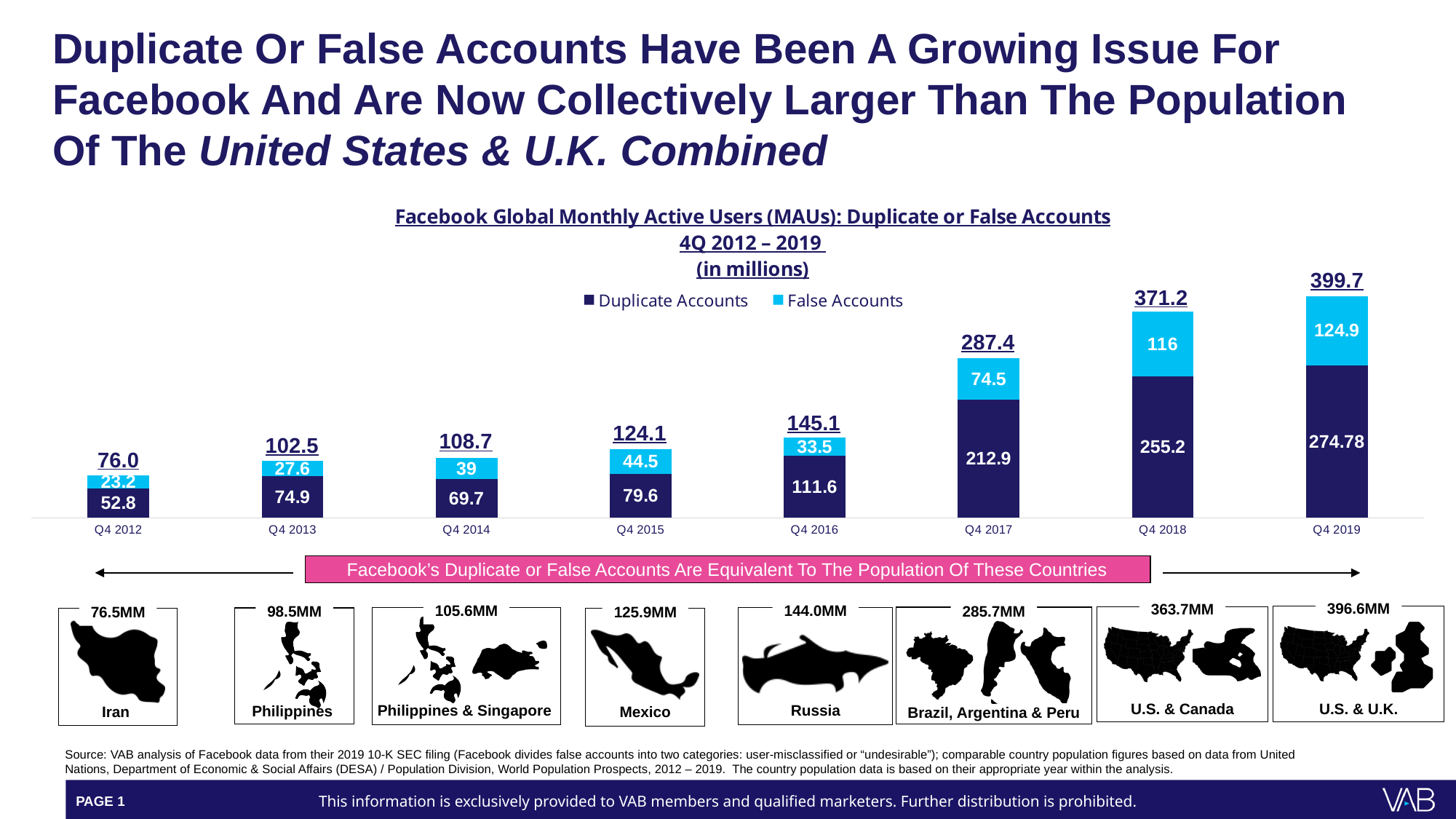
What is the difference between the False Accounts values for Q4 2018 and Q4 2017? 41.5 What is the value of False Accounts for Q4 2015? 44.5 Which quarter has the lowest value for False Accounts? Q4 2012 What is the total of the stacked bar for Q4 2017? 287.4 What is the value of Duplicate Accounts for Q4 2016? 111.6 How many quarters are shown on the x axis of the chart? 8 How many series does the chart legend list? 2 Which is larger, the Duplicate Accounts value for Q4 2013 or for Q4 2014? Q4 2013 What kind of chart is shown on the slide? Stacked bar chart Do the total values generally rise or fall from Q4 2012 to Q4 2019? Rise Which quarter has the highest total of duplicate or false accounts? Q4 2019 What is the value of Duplicate Accounts for Q4 2019? 274.78